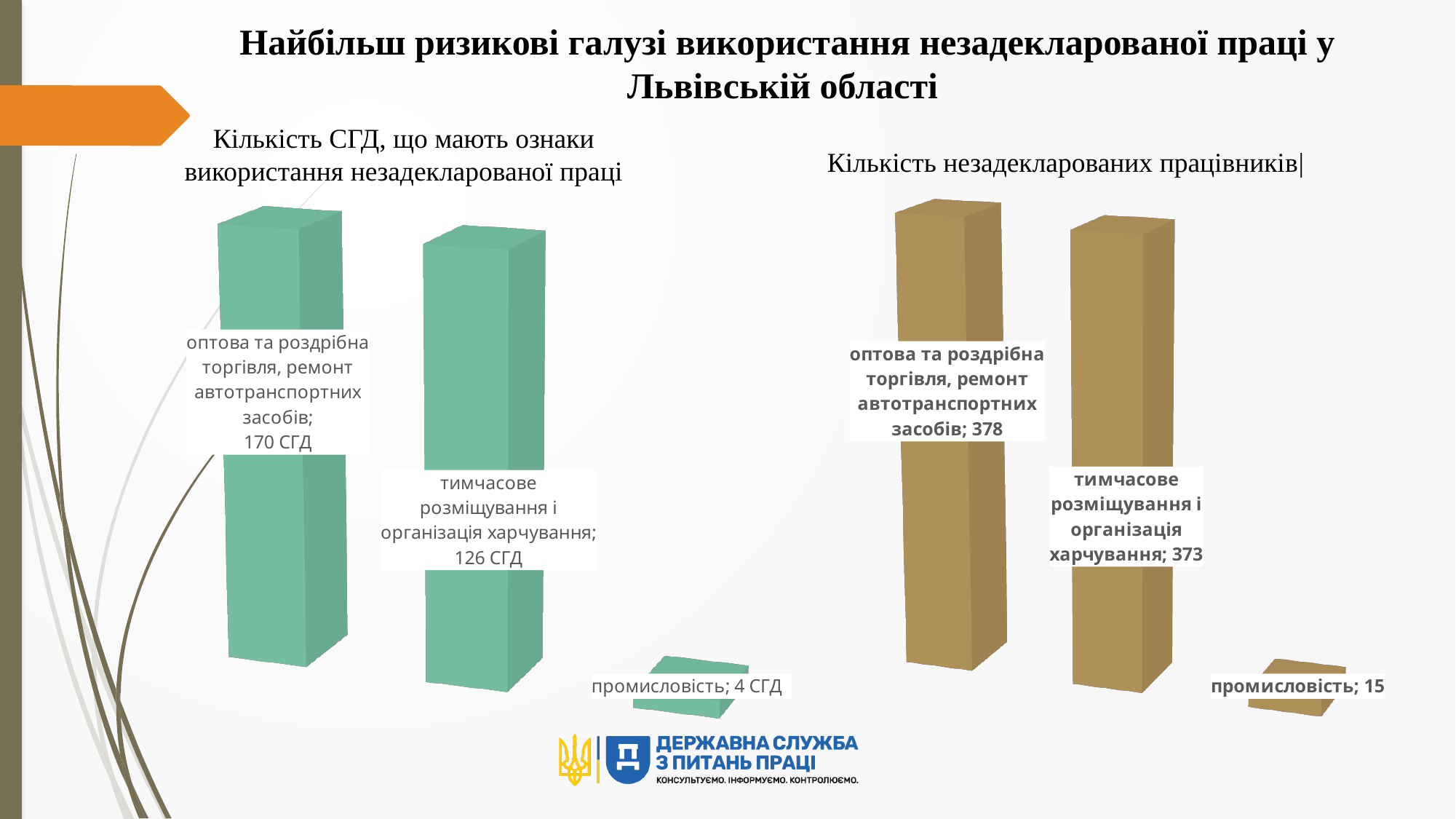
In the left chart (Кількість СГД, що мають ознаки використання незадекларованої праці), what is the value for промисловість? 4 СГД In the right chart (Кількість незадекларованих працівників), what is the value for тимчасове розміщування і організація харчування? 373 What kind of chart is the left chart (Кількість СГД, що мають ознаки використання незадекларованої праці)? Bar chart In the left chart (Кількість СГД, що мають ознаки використання незадекларованої праці), what is the value for тимчасове розміщування і організація харчування? 126 СГД How many categories are shown in the right chart (Кількість незадекларованих працівників)? 3 In the right chart (Кількість незадекларованих працівників), what is the difference between the values for тимчасове розміщування і організація харчування and промисловість? 358 In the left chart (Кількість СГД, що мають ознаки використання незадекларованої праці), what is the value for оптова та роздрібна торгівля, ремонт автотранспортних засобів? 170 СГД In the left chart (Кількість СГД, що мають ознаки використання незадекларованої праці), which category has the lowest value? промисловість In the right chart (Кількість незадекларованих працівників), which category has the highest value? оптова та роздрібна торгівля, ремонт автотранспортних засобів In the right chart (Кількість незадекларованих працівників), what is the value for промисловість? 15 In the left chart (Кількість СГД, що мають ознаки використання незадекларованої праці), what is the difference between the values for оптова та роздрібна торгівля and тимчасове розміщування і організація харчування? 44 СГД In the right chart (Кількість незадекларованих працівників), what is the value for оптова та роздрібна торгівля, ремонт автотранспортних засобів? 378